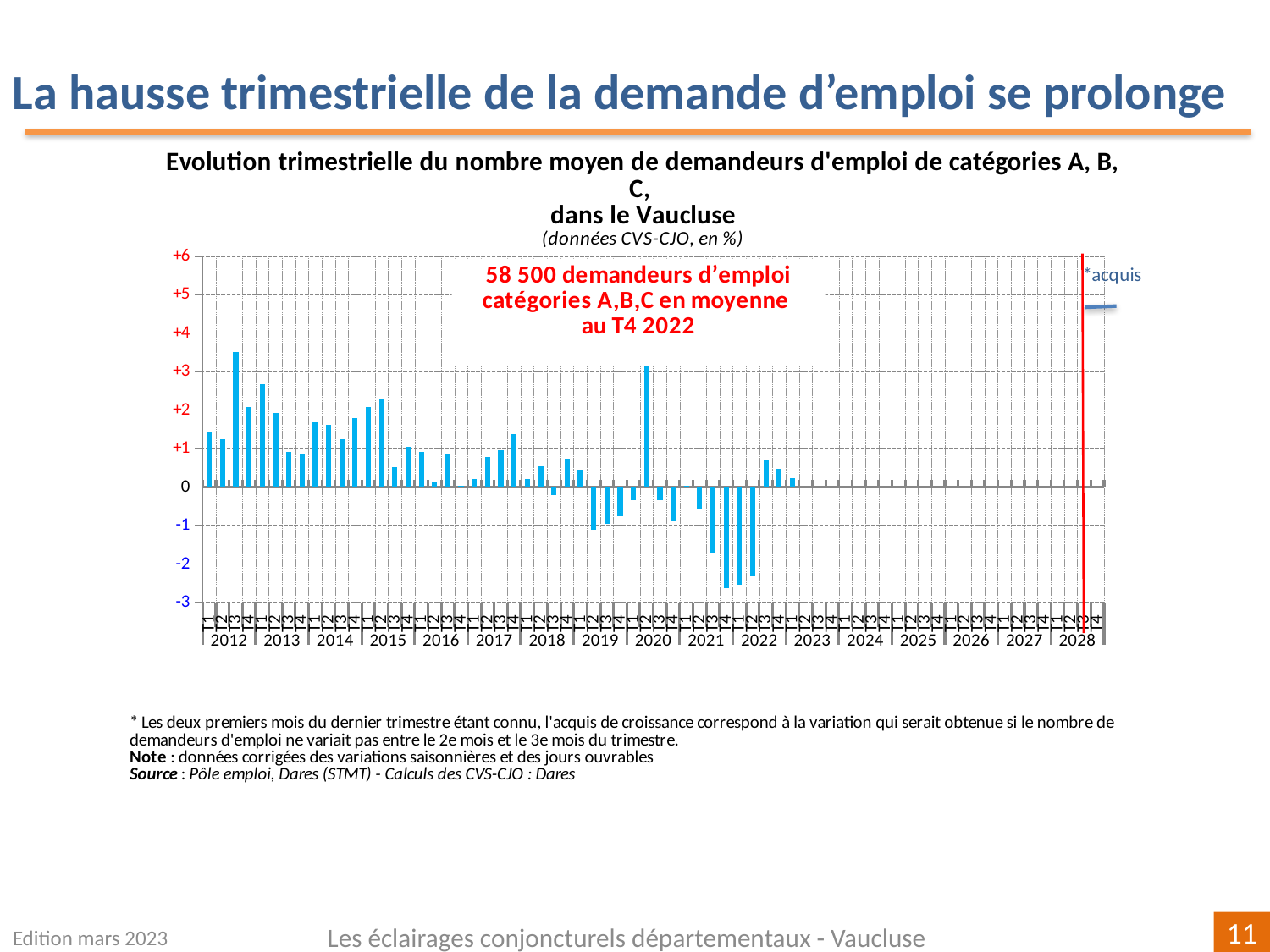
How many year labels are shown on the x axis? 17 Is the value for T3 2021 greater or less than -2? greater What kind of chart is shown on the slide? bar chart Is the value for T3 2012 greater or less than +3? greater According to the red annotation on the chart, how many demandeurs d'emploi catégories A,B,C were there on average in T4 2022? 58 500 Is the value for T1 2013 greater or less than +2? greater Which is larger, the value for T1 2020 or the value for T3 2021? T1 2020 What is the highest value shown on the y axis? +6 Which is larger, the value for T3 2012 or the value for T1 2013? T3 2012 From T1 2021 to T3 2021, do the values rise or fall? fall